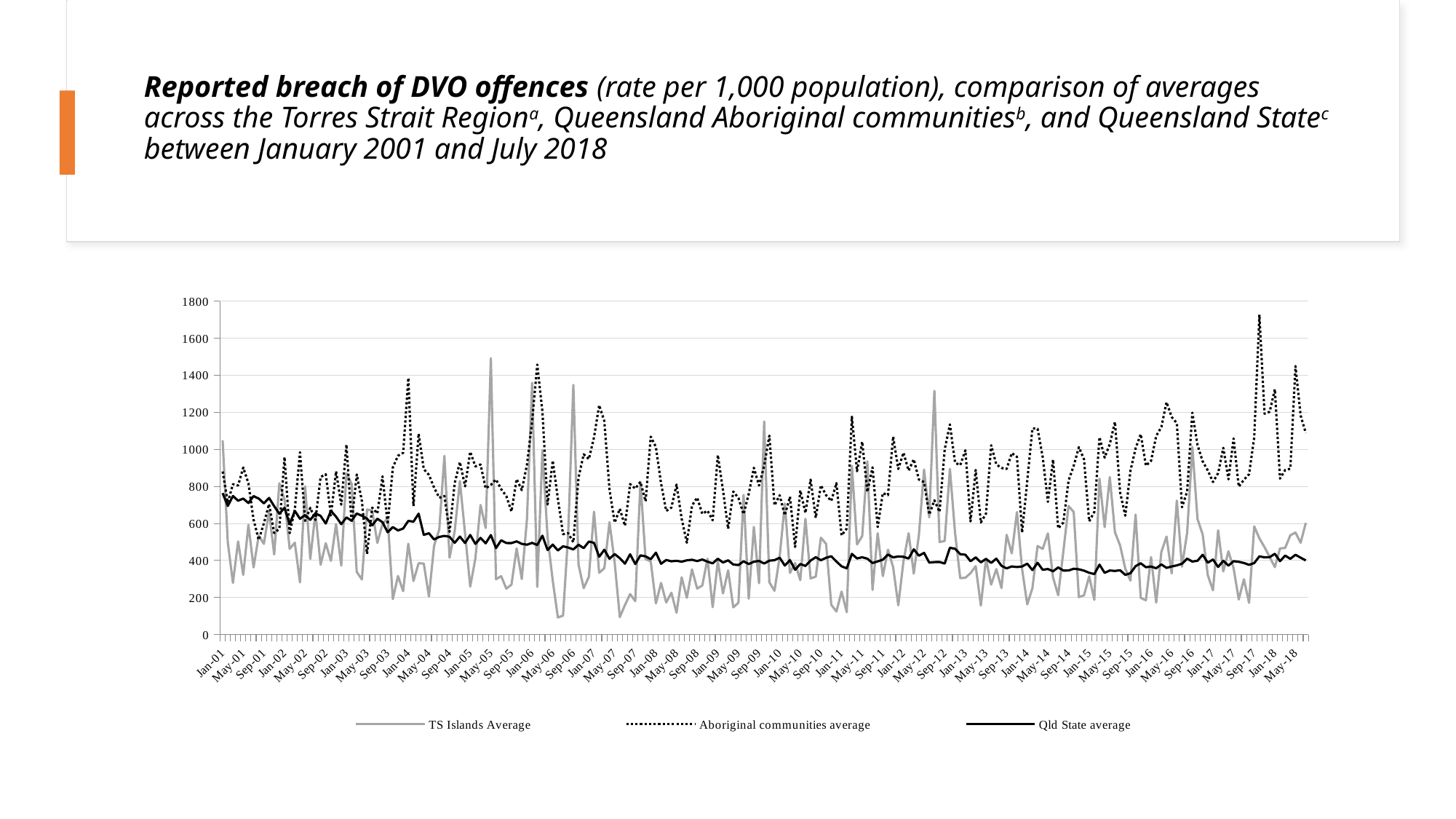
Is the peak value of the Aboriginal communities average around Sep-17 greater or less than 1600? greater Is the value for the Qld State average at Jan-01 greater or less than 600? greater Which series reaches the highest value anywhere on the chart? Aboriginal communities average Is the value for the Qld State average at Jan-18 greater or less than 600? less Around Sep-17, which is larger: the Aboriginal communities average or the Qld State average? Aboriginal communities average How many series does the legend list? 3 Which series is drawn with a dotted line? Aboriginal communities average What kind of chart is shown on the slide? Line chart Which series drops to the lowest value anywhere on the chart? TS Islands Average What is the highest value shown on the vertical axis? 1800 Does the Aboriginal communities average rise or fall overall from Jan-01 to May-18? Rise Does the Qld State average rise or fall overall from Jan-01 to May-18? Fall